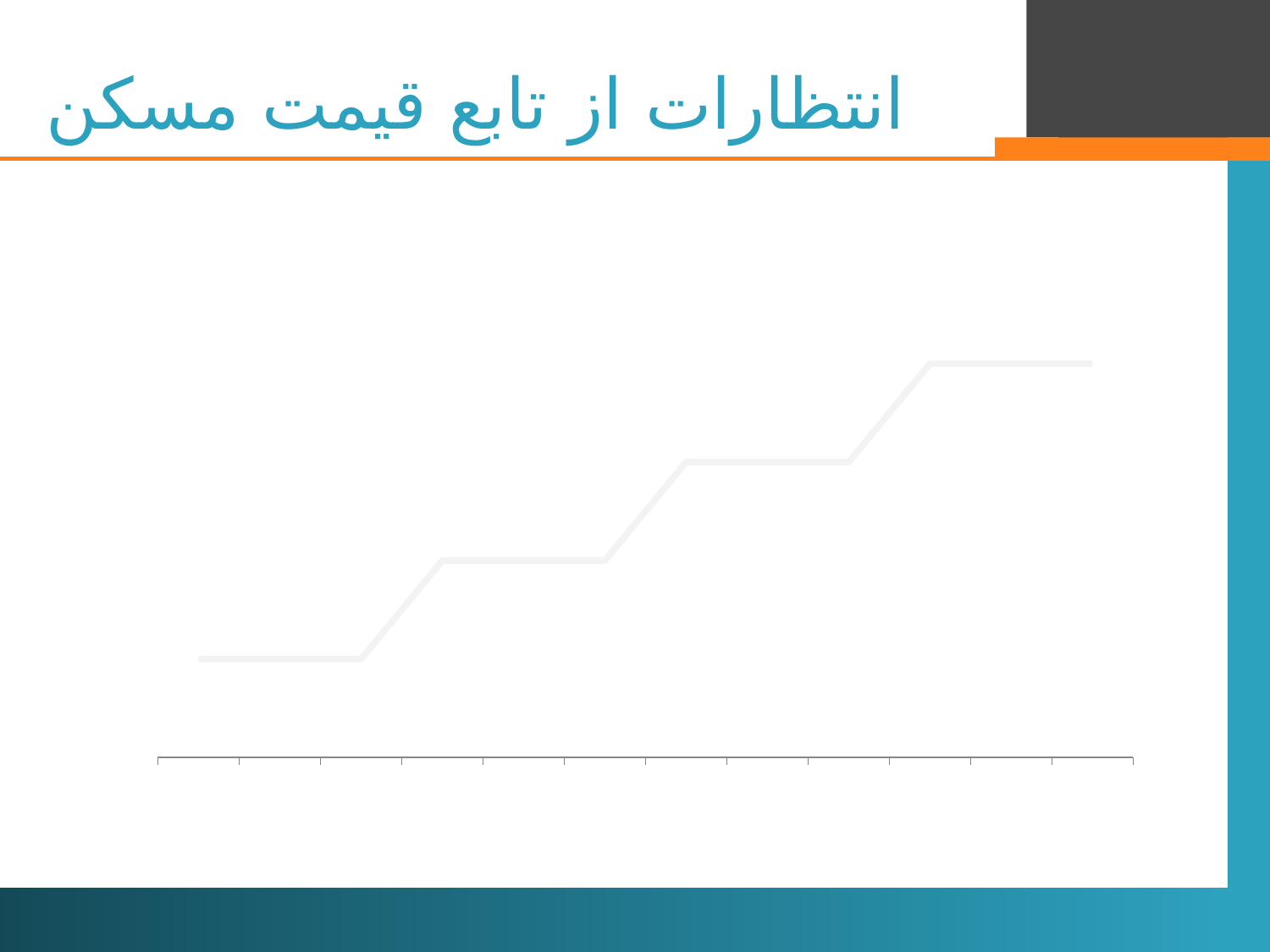
Do the values of the line rise or fall from left to right along the x axis? rise What is the title written at the top of the slide above the chart? انتظارات از تابع قیمت مسکن How many lines (series) are plotted on the chart? 1 Does the chart display a legend? No What kind of chart is shown on the slide? line chart